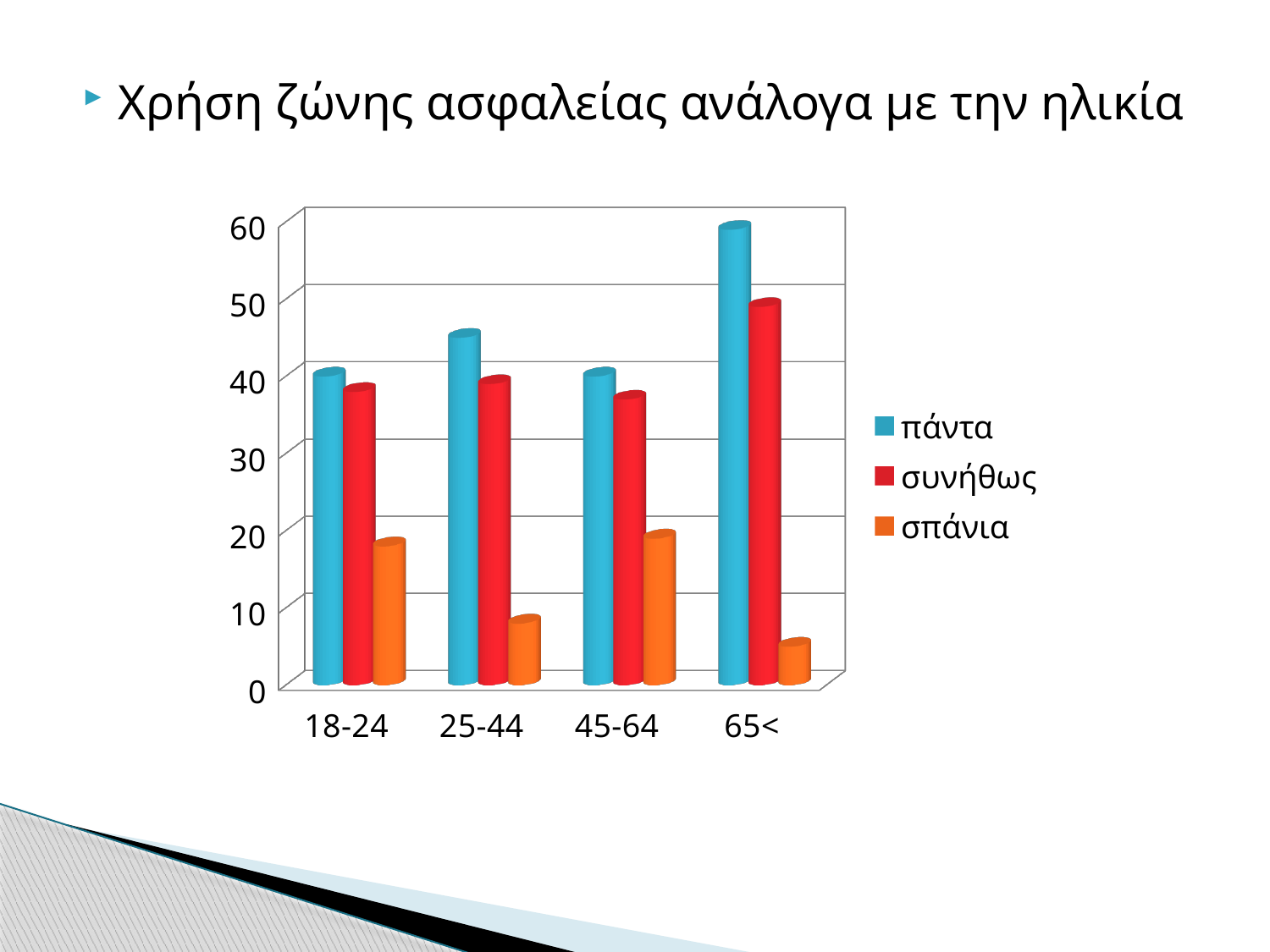
Which age group has the highest value for πάντα? 65< Is the value for σπάνια in the 18-24 age group greater or less than 10? greater Which age group has the lowest value for σπάνια? 65< How many age groups are shown on the x axis of the chart? 4 Which series is shown in orange in the chart's legend? σπάνια What kind of chart is shown on the slide? Bar chart Is the value for σπάνια in the 65< age group greater or less than 10? less Which is larger: συνήθως for 65< or συνήθως for 18-24? συνήθως for 65< Is the value for συνήθως in the 65< age group greater or less than 40? greater How many series does the chart's legend list? 3 For the 65< age group, which is larger: πάντα or σπάνια? πάντα